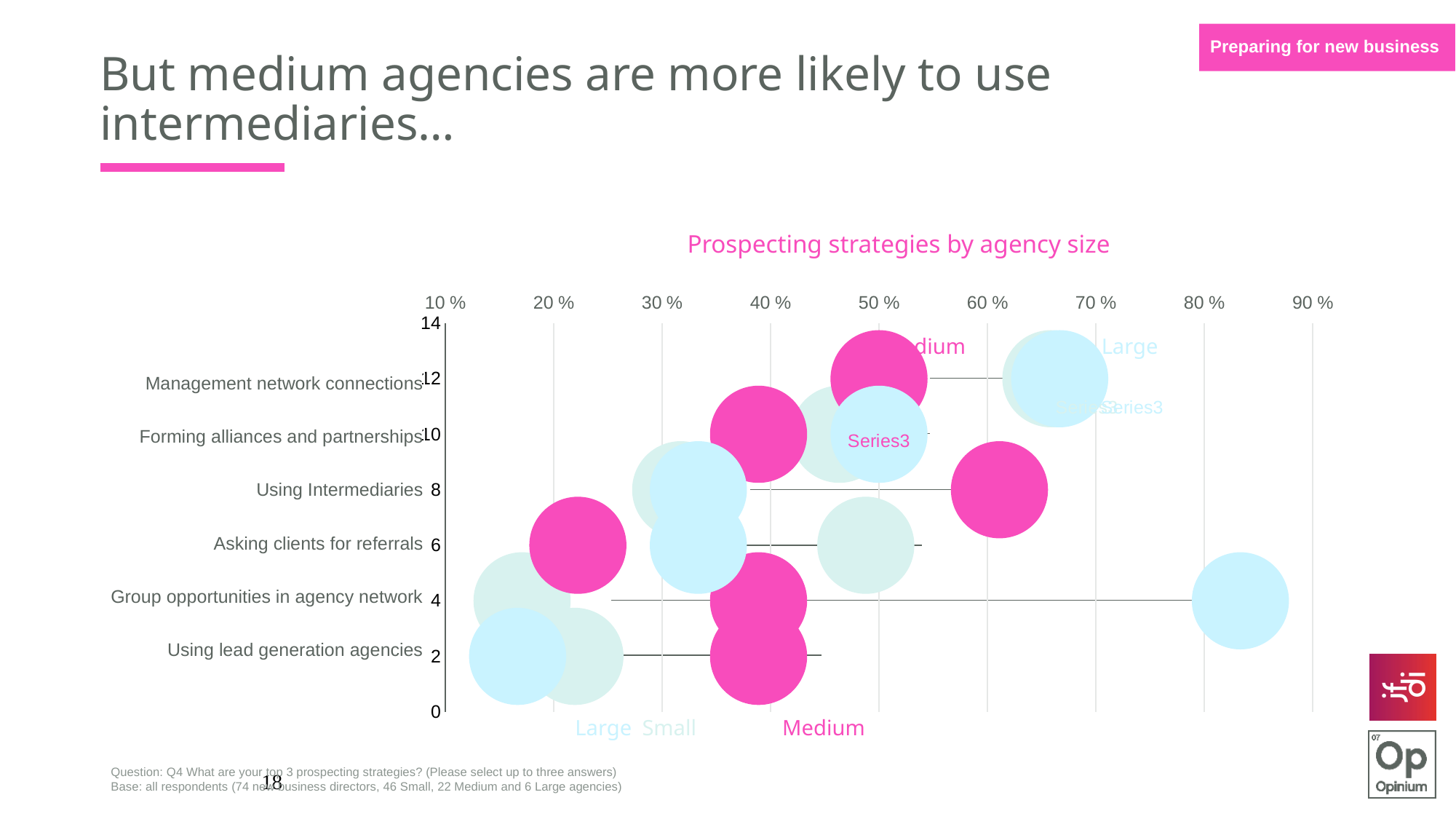
How many prospecting strategy categories are listed on the chart's vertical axis? 6 Which agency sizes are listed in the chart legend? Large, Small, Medium For Group opportunities in agency network, which agency size has the higher value, Large or Medium? Large For Using Intermediaries, which agency size has the higher value, Medium or Large? Medium Is the value for Large agencies for Management network connections greater or less than 60%? greater Is the value for Medium agencies for Using Intermediaries greater or less than 50%? greater What kind of chart is shown on the slide? Bubble chart How many agency-size series does the chart legend list? 3 Is the value for Large agencies for Group opportunities in agency network greater or less than 70%? greater What is the title of the chart? Prospecting strategies by agency size